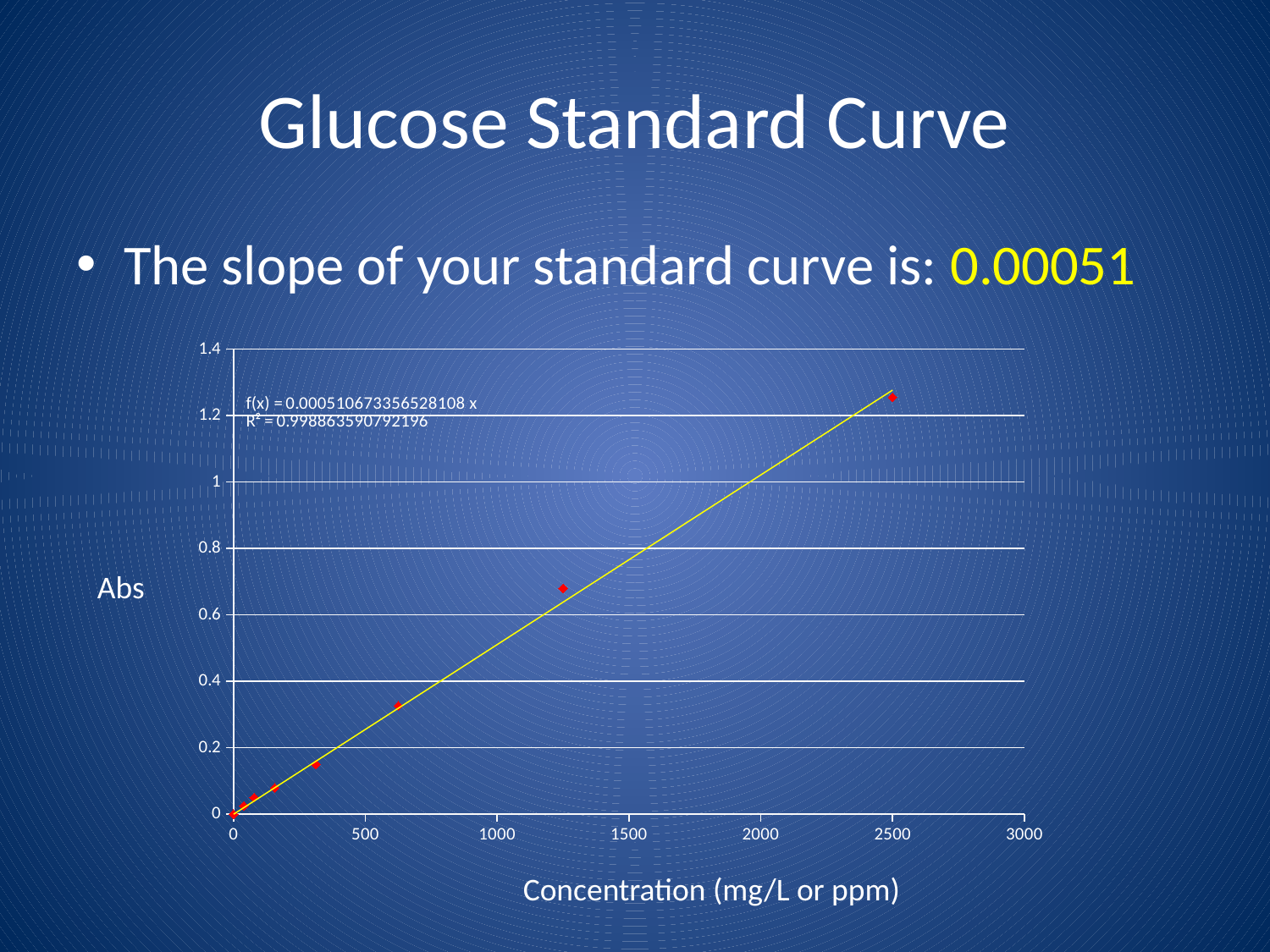
At which concentration is the absorbance highest? 2500 What is the title of the slide containing the chart? Glucose Standard Curve Is the absorbance value at a concentration of 1250 greater or less than 0.6? greater What kind of chart is shown on the slide? scatter chart What is the maximum value shown on the y axis of the chart? 1.4 What is the label of the x axis of the chart? Concentration (mg/L or ppm) Is the absorbance value at a concentration of 1250 greater or less than 0.8? less Is the absorbance value at a concentration of about 625 greater or less than 0.4? less Which has the larger absorbance: the point at concentration 1250 or the point at concentration 2500? 2500 Do the absorbance values rise or fall as concentration increases along the x axis? rise At which concentration is the absorbance lowest? 0